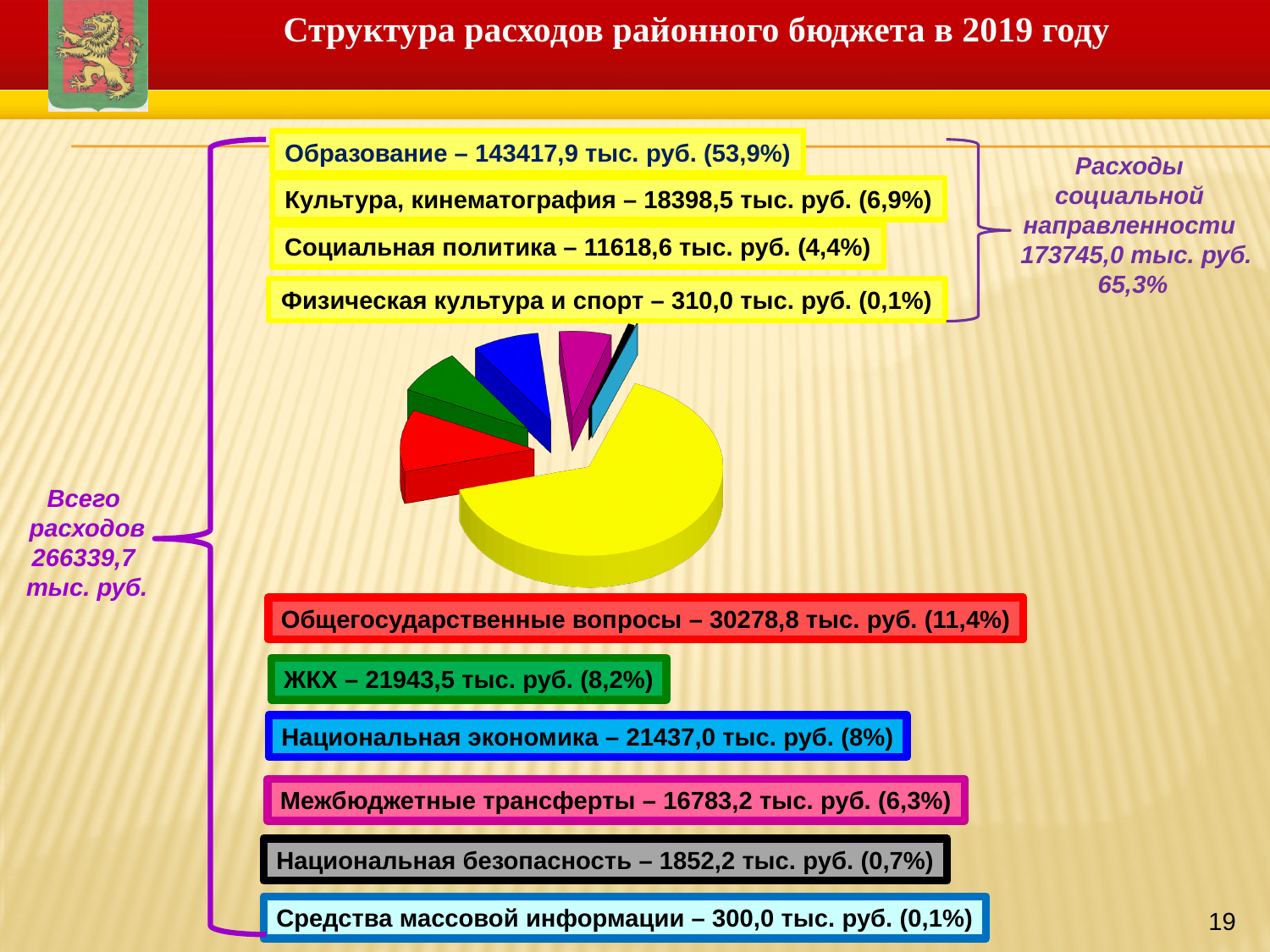
What is the value for ЖКХ? 21943,5 тыс. руб. What is the difference between Общегосударственные вопросы and ЖКХ in тыс. руб.? 8335,3 тыс. руб. What is the total of all expenses shown on the slide? 266339,7 тыс. руб. What share of expenses does Общегосударственные вопросы account for? 11,4% What is the title of the slide containing the chart? Структура расходов районного бюджета в 2019 году What is the value for Образование? 143417,9 тыс. руб. What share of expenses does Межбюджетные трансферты account for? 6,3% What share of expenses do the social-oriented expenses (Расходы социальной направленности) account for? 65,3% Which is larger, ЖКХ or Национальная экономика? ЖКХ What is the value for Национальная безопасность? 1852,2 тыс. руб. Which expense category has the largest share? Образование What kind of chart is shown on the slide? pie chart